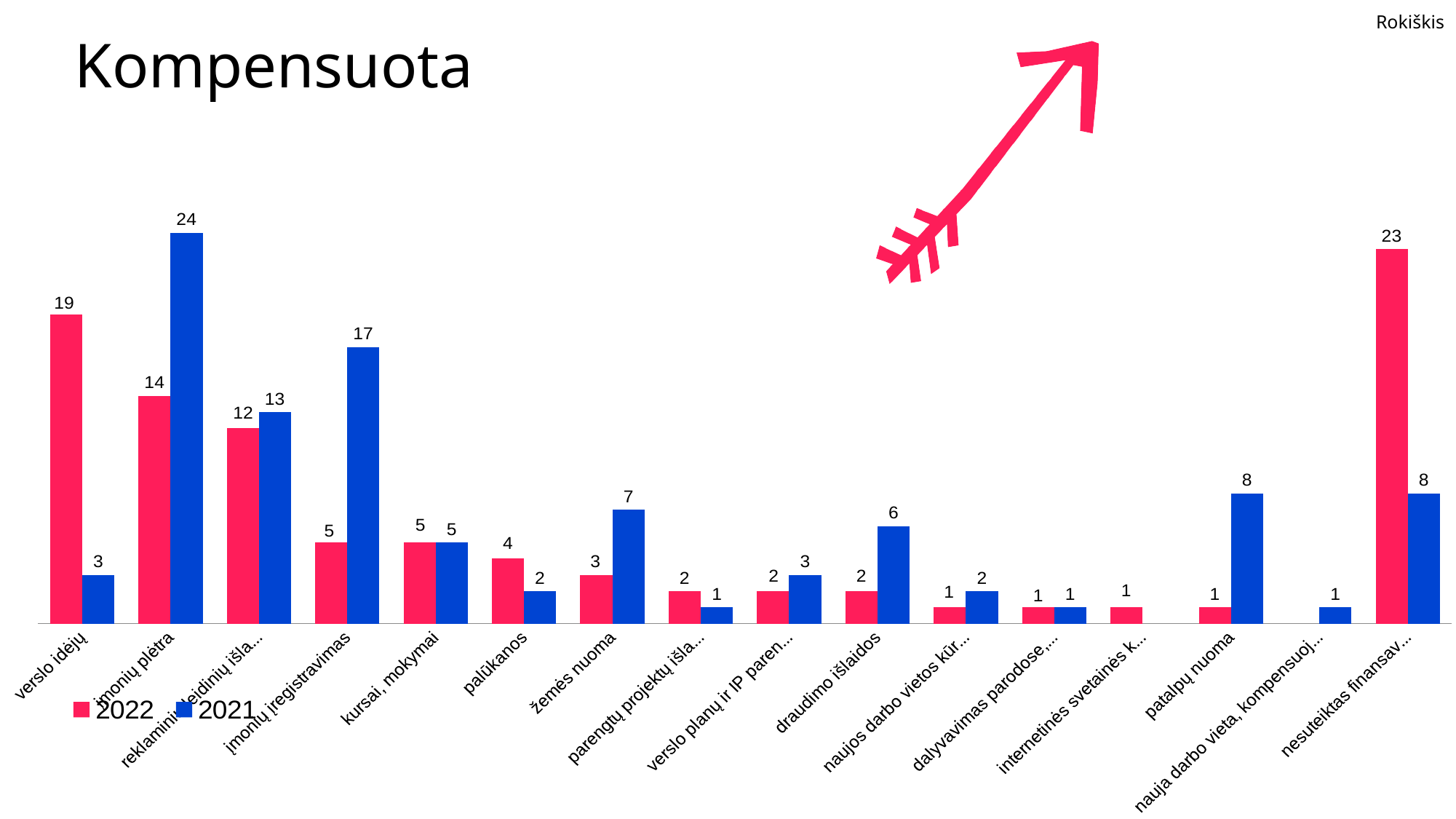
Which category has the highest 2022 value? nesuteiktas finansav... What is the title of the chart? Kompensuota What kind of chart is shown on the slide? bar chart What is the 2021 value for įmonių įregistravimas? 17 Which is larger for žemės nuoma, the 2022 value or the 2021 value? 2021 How many series does the legend list? 2 What is the difference between the 2021 and 2022 values for įmonių įregistravimas? 12 What is the 2021 value for įmonių plėtra? 24 Which is larger for palūkanos, the 2022 value or the 2021 value? 2022 Which category has the highest 2021 value? įmonių plėtra What is the 2022 value for verslo idėjų? 19 What is the 2022 value for patalpų nuoma? 1